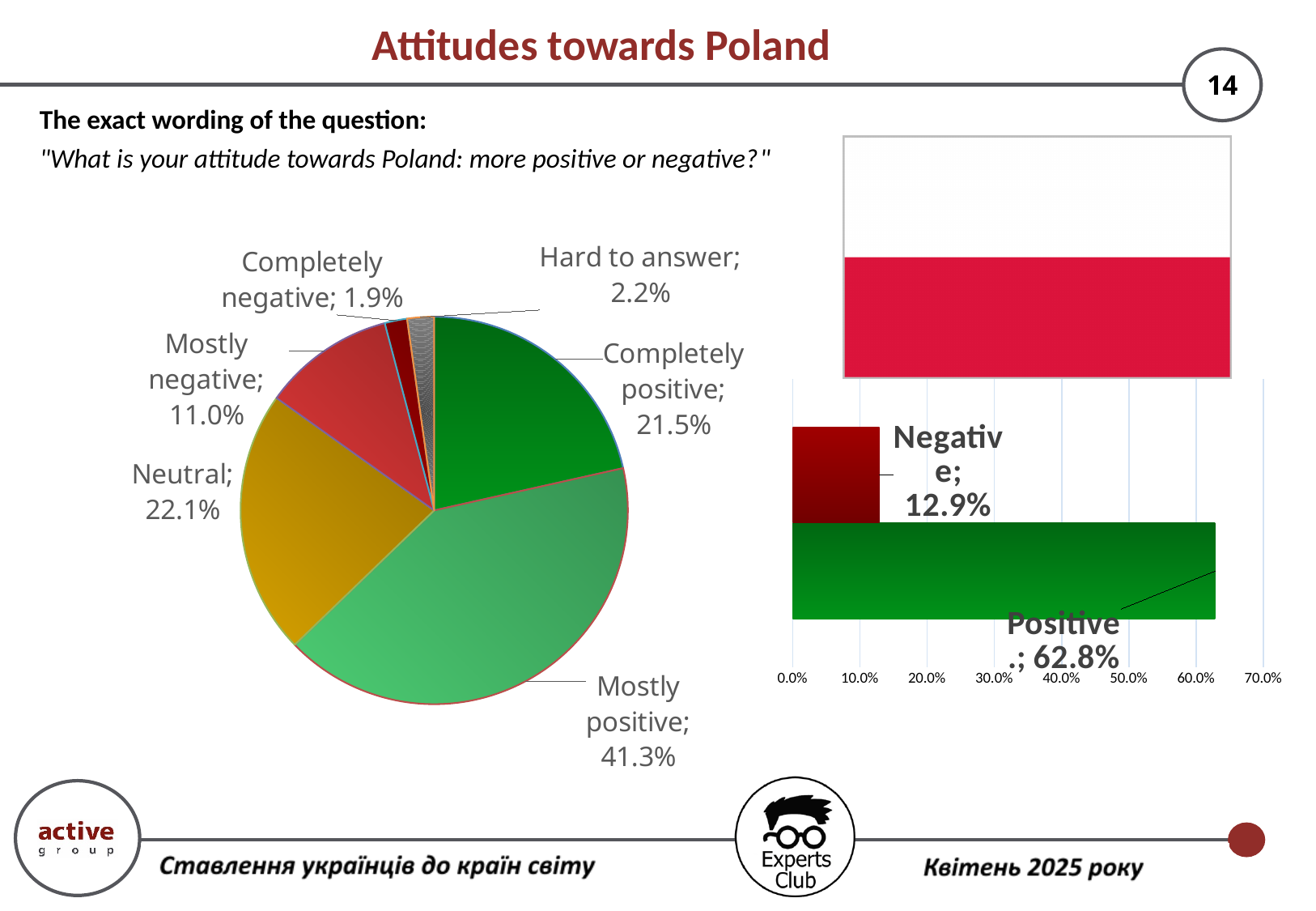
In the pie chart on the left, what share is labelled for Mostly positive? 41.3% In the bar chart on the right, what is the value for Negative? 12.9% In the pie chart on the left, which is larger: Neutral or Mostly negative? Neutral In the pie chart on the left, what is the difference between the Mostly positive and Completely positive shares? 19.8% In the bar chart on the right, what is the value for Positive? 62.8% What type of chart is shown on the right side of the slide? Bar chart In the bar chart on the right, what is the difference between the Positive and Negative values? 49.9% In the pie chart on the left, what share is labelled for Completely negative? 1.9% In the pie chart on the left, which category has the largest slice? Mostly positive In the pie chart on the left, what share is labelled for Neutral? 22.1% In the pie chart on the left, which category has the smallest slice? Completely negative In the pie chart on the left, how many slices are there? 6